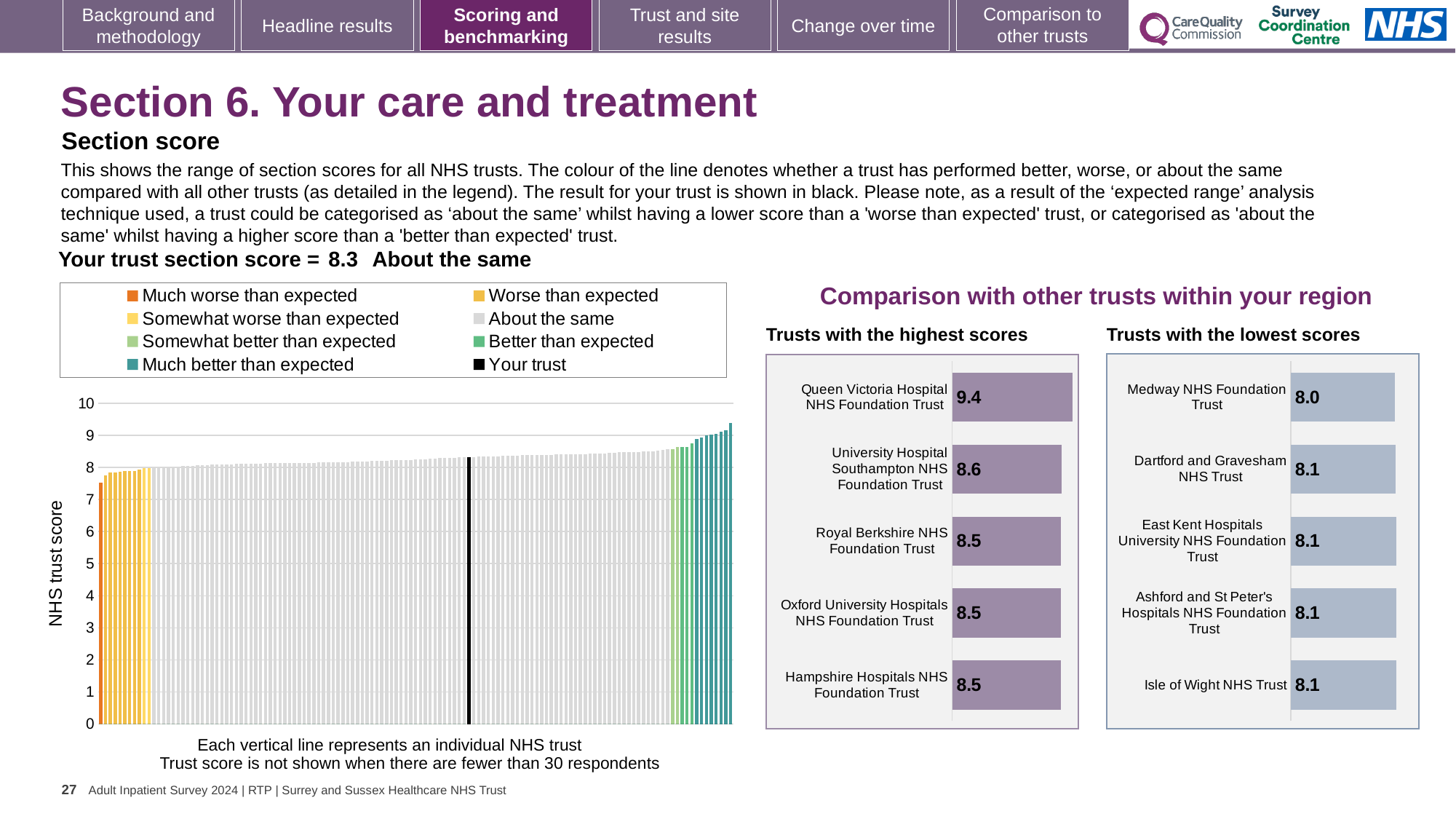
In the 'Trusts with the lowest scores' chart, what is the score for Medway NHS Foundation Trust? 8.0 What kind of chart is the large chart on the left showing NHS trust scores? Bar chart In the 'Trusts with the highest scores' chart, what is the score for Queen Victoria Hospital NHS Foundation Trust? 9.4 In the 'Trusts with the lowest scores' chart, what is the difference between the scores of Dartford and Gravesham NHS Trust and Medway NHS Foundation Trust? 0.1 How many trusts are shown in the 'Trusts with the highest scores' chart? 5 In the 'Trusts with the lowest scores' chart, which trust has the lowest score? Medway NHS Foundation Trust In the 'Trusts with the highest scores' chart, which has the higher score: University Hospital Southampton NHS Foundation Trust or Royal Berkshire NHS Foundation Trust? University Hospital Southampton NHS Foundation Trust In the large chart on the left, what is the section score for your trust (the black bar)? 8.3 In the 'Trusts with the highest scores' chart, what is the difference between the scores of Queen Victoria Hospital NHS Foundation Trust and University Hospital Southampton NHS Foundation Trust? 0.8 How many entries does the legend of the large chart on the left list? 8 How many trusts are shown in the 'Trusts with the lowest scores' chart? 5 In the 'Trusts with the highest scores' chart, which trust has the highest score? Queen Victoria Hospital NHS Foundation Trust